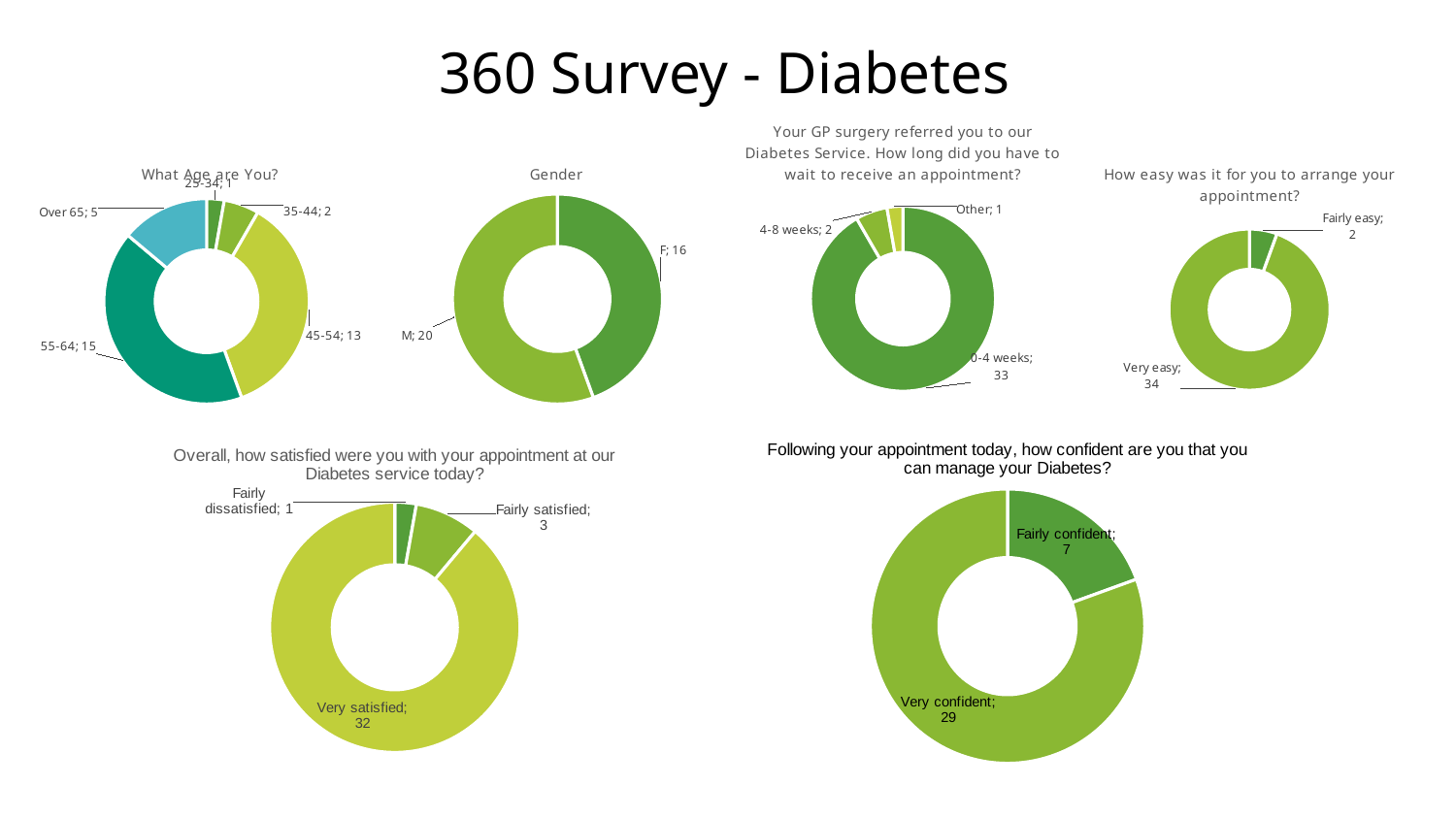
In the 'What Age are You?' chart, how many age categories are shown? 5 In the 'Gender' chart, what is the difference between the M and F values? 4 What type of chart is used for the 'Gender' data? Doughnut (pie) chart In the chart about how long you had to wait to receive an appointment, how many respondents waited 0-4 weeks? 33 In the chart about how long you had to wait to receive an appointment, which category has the highest value? 0-4 weeks In the 'Gender' chart, what is the value for M? 20 In the chart about confidence in managing your Diabetes, what is the value for Very confident? 29 In the chart about overall satisfaction with the appointment, which is larger: Fairly satisfied or Fairly dissatisfied? Fairly satisfied In the 'How easy was it for you to arrange your appointment?' chart, what is the value for Fairly easy? 2 In the 'What Age are You?' chart, how many respondents are in the 55-64 category? 15 In the 'How easy was it for you to arrange your appointment?' chart, what share of the total does Very easy represent? 34 out of 36 In the 'What Age are You?' chart, which age category has the lowest count? 25-34